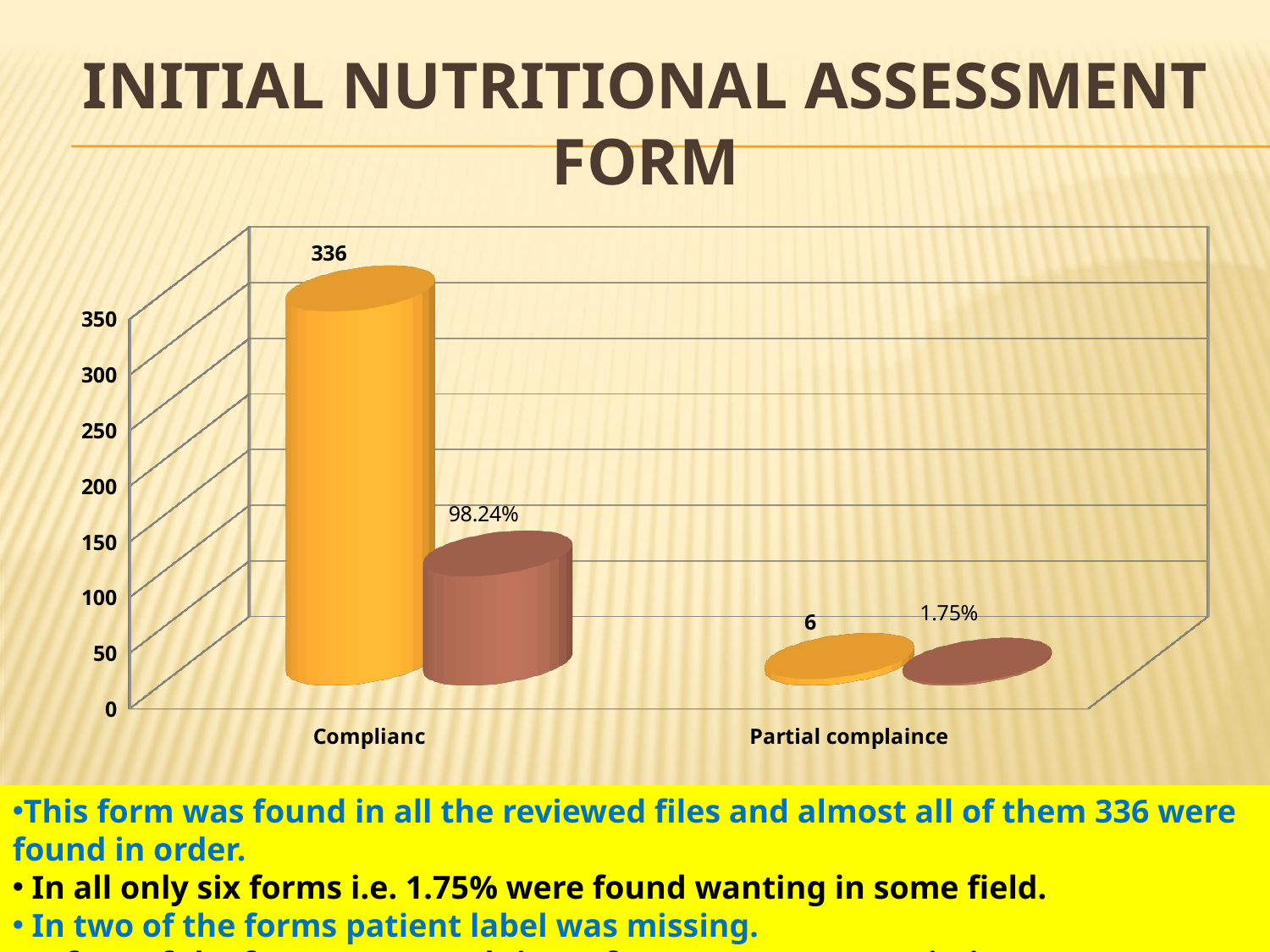
What is the difference between the count for Complianc and the count for Partial complaince? 330 How many categories are shown on the x axis of the chart? 2 What is the count value shown for the Partial complaince category? 6 Which category has the lowest count value? Partial complaince Which is larger, the count for Complianc or the count for Partial complaince? Complianc Is the count value for Complianc greater or less than 300? greater What is the highest value labelled on the vertical axis of the chart? 350 What percentage is shown for the Complianc category? 98.24% What kind of chart is shown on the slide? bar chart What percentage is shown for the Partial complaince category? 1.75% What is the count value shown for the Complianc category? 336 Which category has the highest count value? Complianc